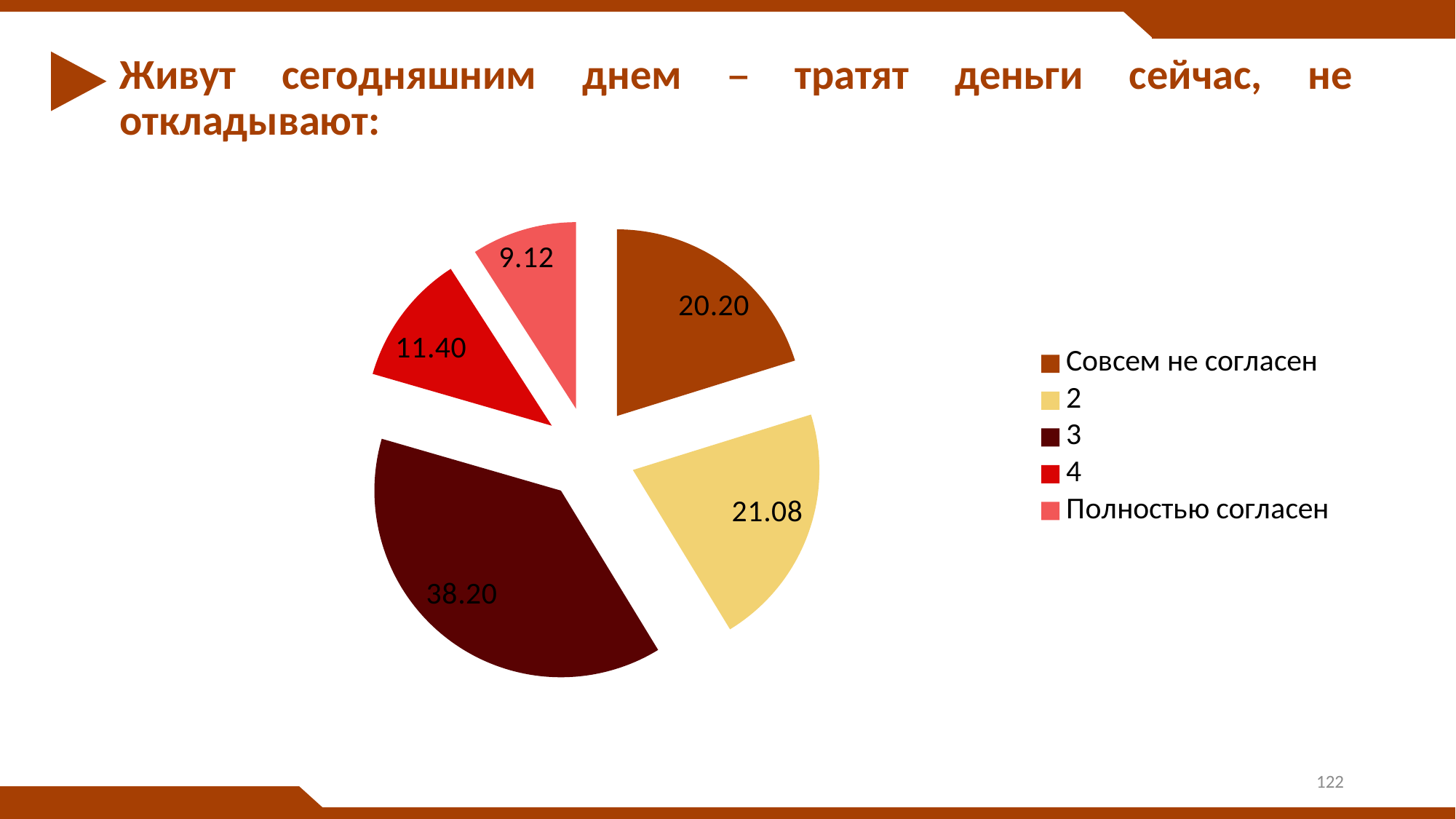
Which category has the smallest slice? Полностью согласен What is the value for "Совсем не согласен"? 20.20 What is the value for "Полностью согласен"? 9.12 How many slices does the pie chart have? 5 What colour is the slice for category "2"? light yellow What is the value for category "4"? 11.40 What is the value for category "3"? 38.20 What is the difference between the values for "3" and "2"? 17.12 Which is larger, the value for "Совсем не согласен" or the value for "4"? Совсем не согласен What kind of chart is shown on the slide? pie chart What is the combined value of "4" and "Полностью согласен"? 20.52 Which category has the largest slice? 3